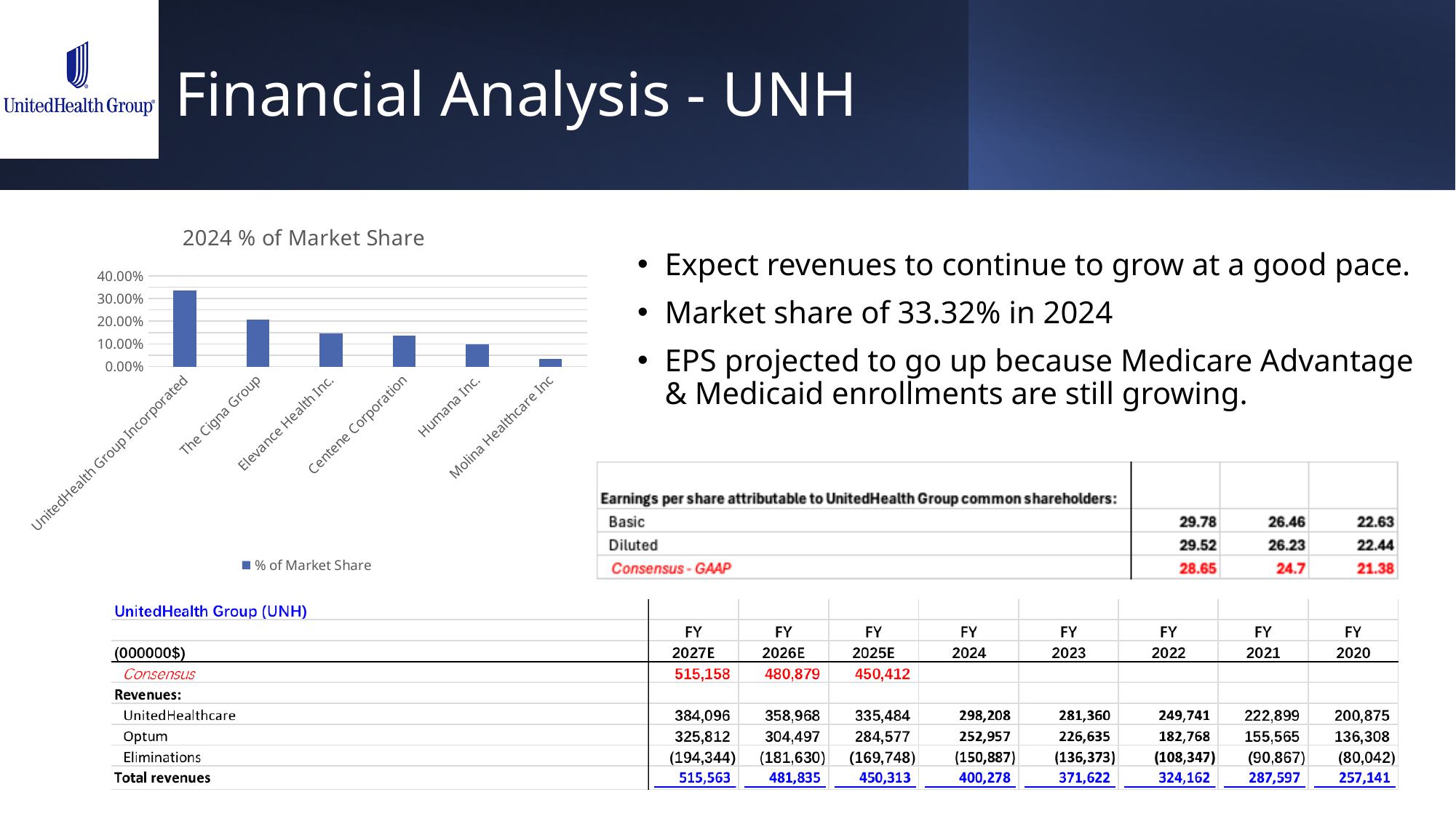
Which company has the lowest market share in the chart? Molina Healthcare Inc How many companies are shown in the chart? 6 What is the title of the chart? 2024 % of Market Share What kind of chart is shown on the slide? bar chart How many series does the chart legend list? 1 Is the value for Molina Healthcare Inc greater or less than 10.00%? less Which has a larger market share, UnitedHealth Group Incorporated or The Cigna Group? UnitedHealth Group Incorporated Which company has the highest market share in the chart? UnitedHealth Group Incorporated Do the bar values rise or fall from left to right across the chart? fall Is the value for The Cigna Group greater or less than 30.00%? less What is the legend entry of the chart? % of Market Share Is the value for UnitedHealth Group Incorporated greater or less than 30.00%? greater